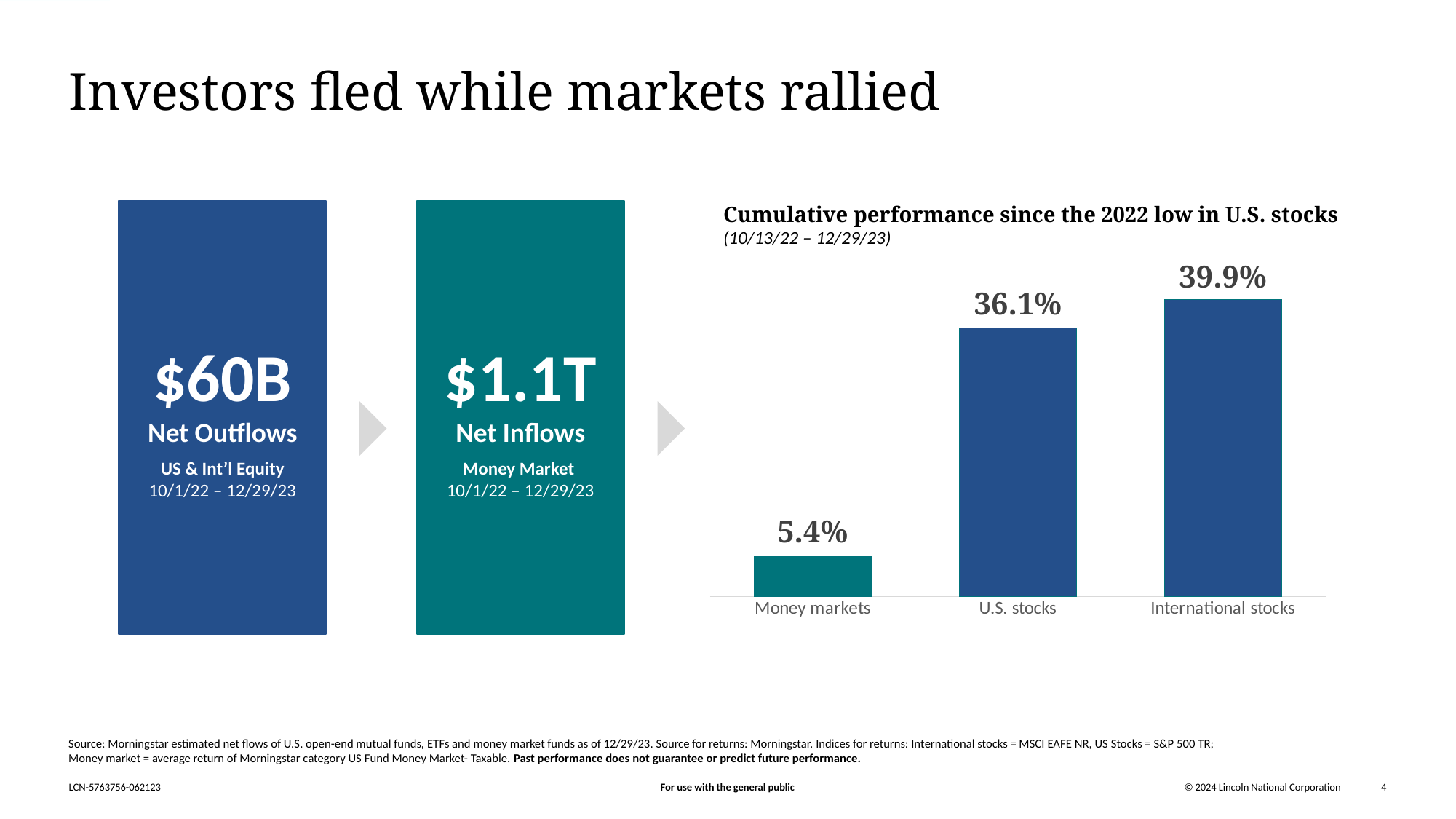
Which category has the lowest cumulative performance in the chart? Money markets Which has a higher cumulative performance, U.S. stocks or Money markets? U.S. stocks What is the difference between the cumulative performance of U.S. stocks and Money markets? 30.7% What is the cumulative performance value shown for Money markets? 5.4% What is the title of the chart on the right side of the slide? Cumulative performance since the 2022 low in U.S. stocks What is the cumulative performance value shown for International stocks? 39.9% Which category has the highest cumulative performance in the chart? International stocks What is the difference between the cumulative performance of International stocks and U.S. stocks? 3.8% What date range is shown under the chart title? 10/13/22 – 12/29/23 What kind of chart is used to show cumulative performance since the 2022 low? Bar chart How many categories are shown in the cumulative performance chart? 3 What is the cumulative performance value shown for U.S. stocks? 36.1%